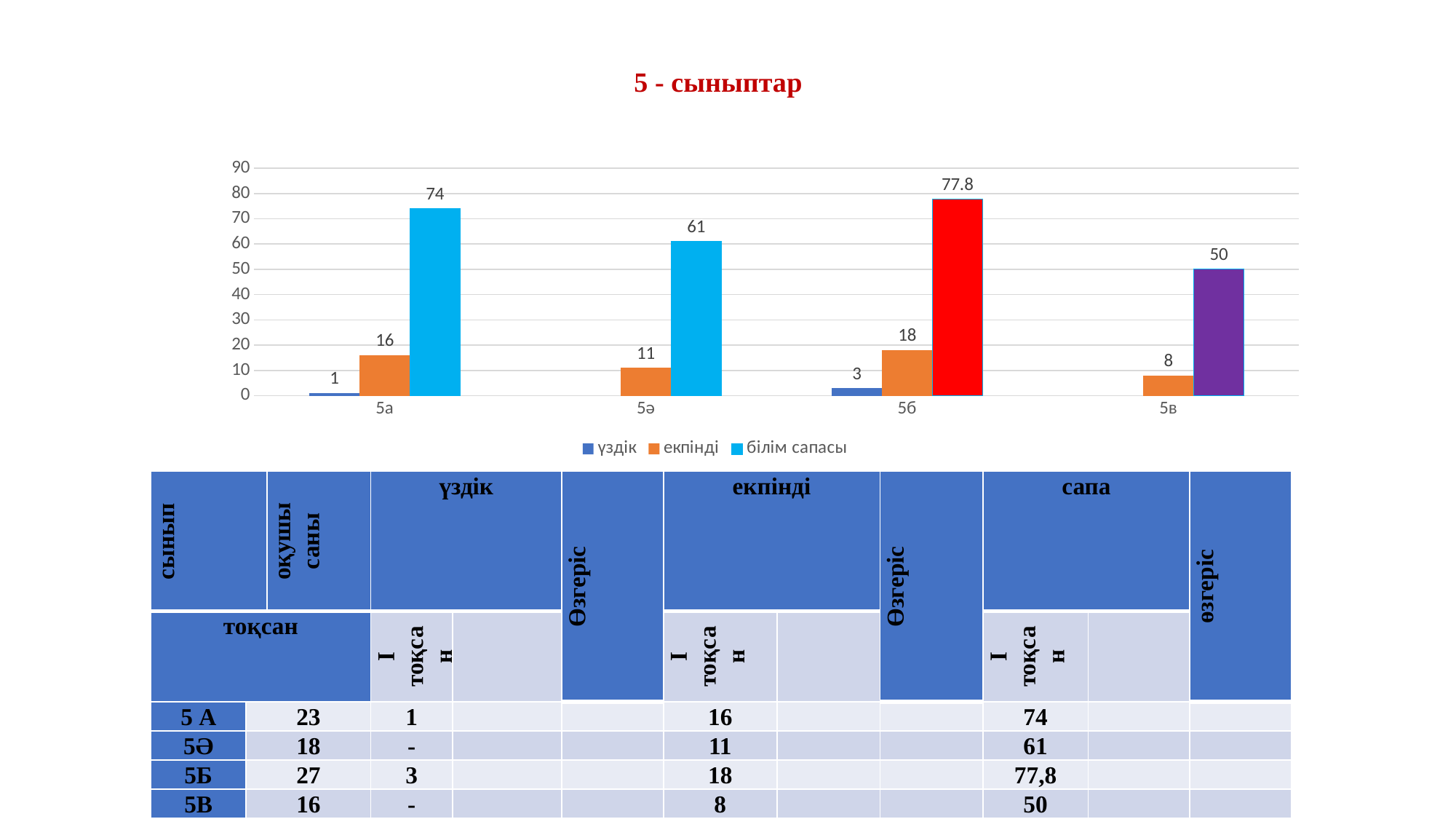
What is the value of білім сапасы for 5в? 50 What is the value of үздік for 5а? 1 How many series does the legend list? 3 Which category has the lowest екпінді value? 5в What is the title of the slide above the chart? 5 - сыныптар What kind of chart is shown on the slide? bar chart Which is larger, the екпінді value for 5а or for 5б? 5б What is the difference between the білім сапасы values for 5а and 5ә? 13 What is the value of екпінді for 5ә? 11 What is the value of білім сапасы for 5б? 77.8 Which category has the highest білім сапасы value? 5б How many categories are shown on the x axis? 4